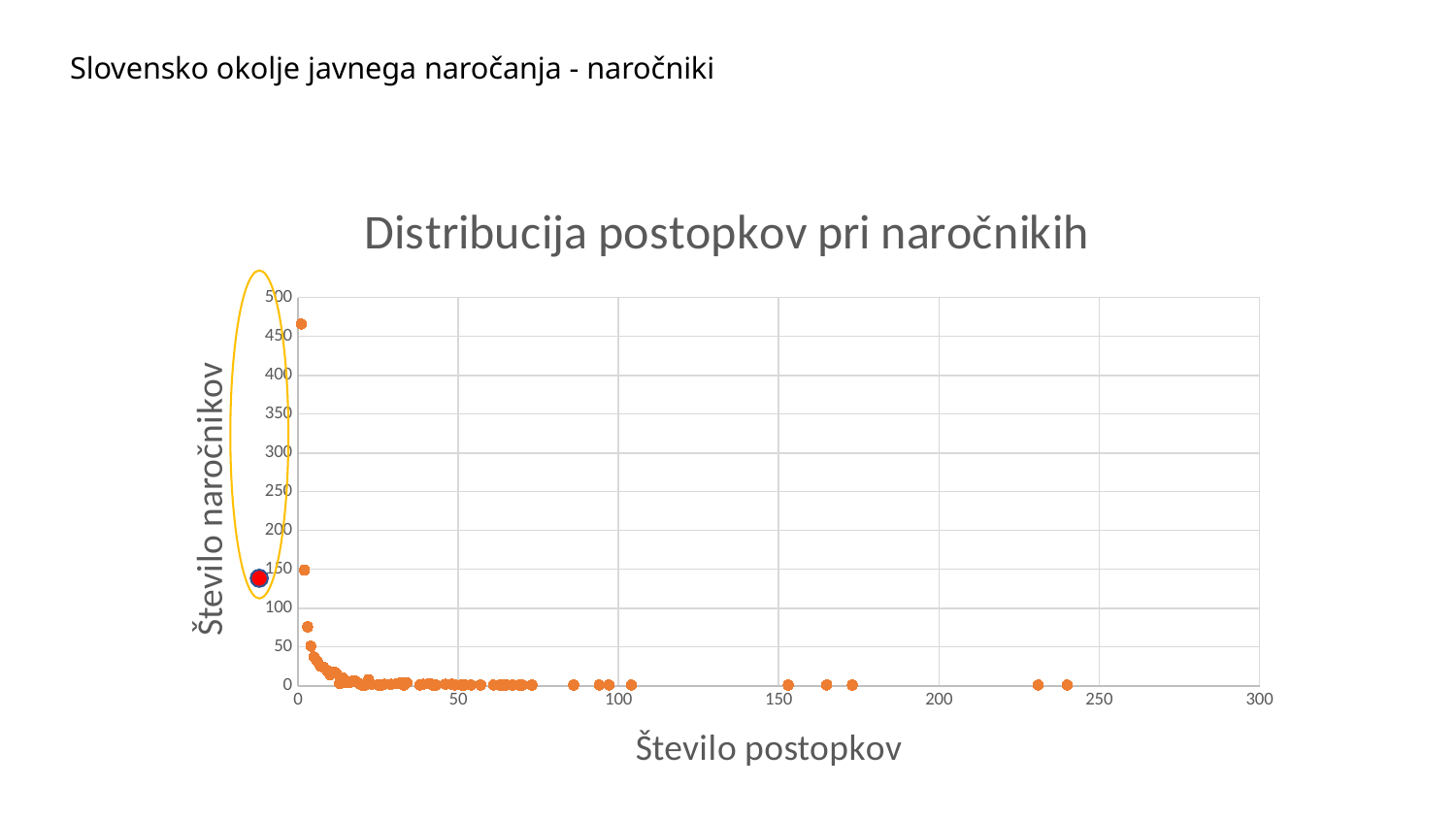
Is the highest plotted value on the y axis greater or less than 400? greater Do the y values generally rise or fall as the number of procedures (x axis) increases? fall Is the highest plotted value on the y axis greater or less than 500? less Is the y value of the second-highest point (near x = 2) greater or less than 100? greater What is the label of the x axis? Število postopkov What kind of chart is shown on the slide? scatter chart What is the maximum value shown on the x axis? 300 Which point has the highest y value: the one near x = 1 or the one near x = 150? the one near x = 1 What is the title of the chart? Distribucija postopkov pri naročnikih